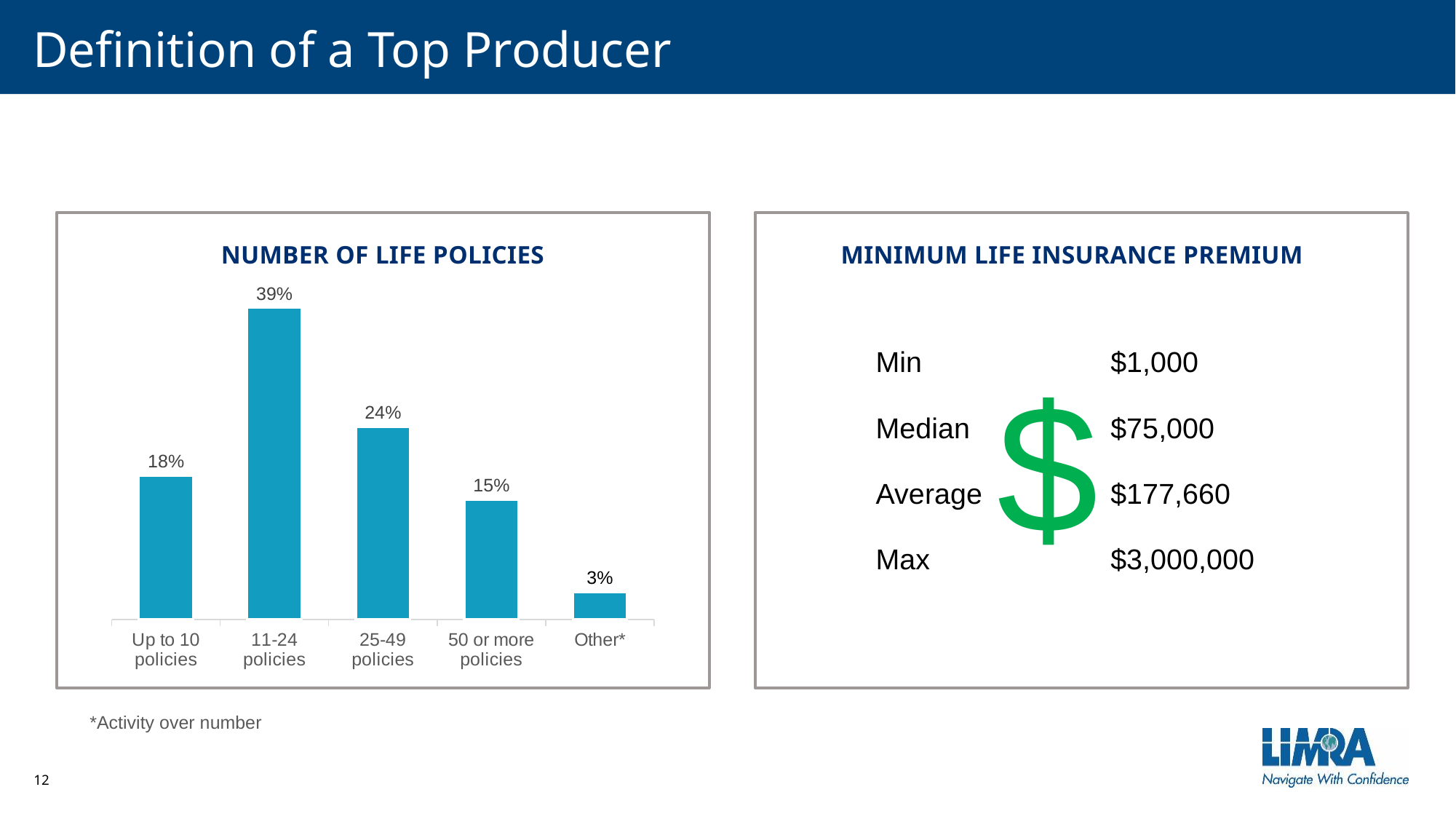
In the Number of Life Policies chart, which is larger: the value for Up to 10 policies or the value for 50 or more policies? Up to 10 policies In the Number of Life Policies chart, what is the difference in percentage points between 11-24 policies and 25-49 policies? 15 In the Number of Life Policies chart, what is the difference in percentage points between 25-49 policies and 50 or more policies? 9 In the Number of Life Policies chart, which category has the lowest percentage? Other* In the Number of Life Policies chart, what percentage is shown for Other*? 3% In the Number of Life Policies chart, what percentage is shown for 50 or more policies? 15% In the Number of Life Policies chart, which category has the highest percentage? 11-24 policies What is the title of the chart on the left side of the slide? NUMBER OF LIFE POLICIES In the Number of Life Policies chart, what percentage is shown for 11-24 policies? 39% In the Number of Life Policies chart, what percentage is shown for Up to 10 policies? 18% What type of chart is the Number of Life Policies chart? Bar chart How many categories are shown in the Number of Life Policies chart? 5